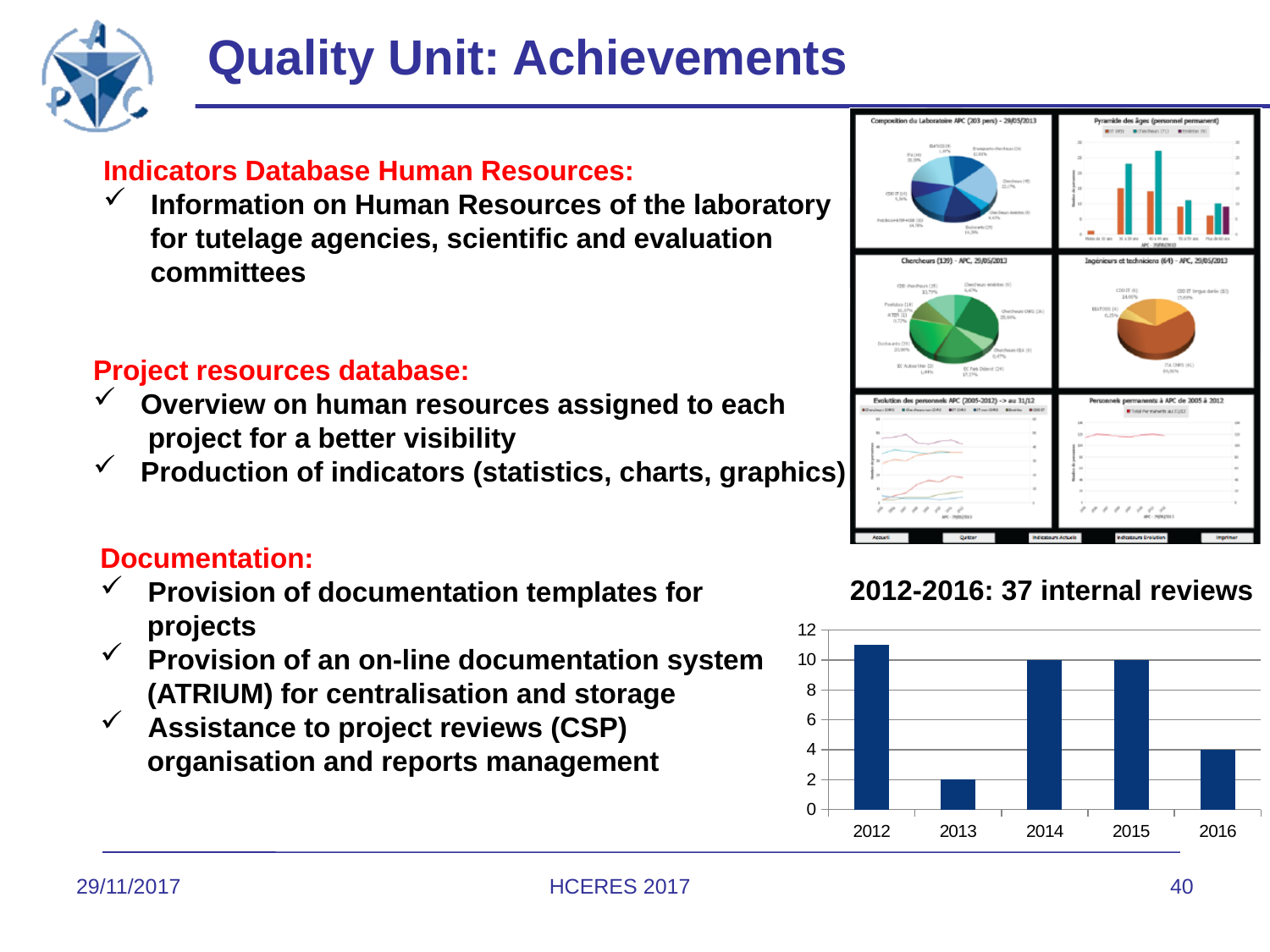
What kind of chart is shown under the heading '2012-2016: 37 internal reviews'? bar chart In the '2012-2016: 37 internal reviews' chart, which year has the larger value, 2014 or 2016? 2014 In the '2012-2016: 37 internal reviews' chart, what is the value for 2014? 10 What is the title printed above the bar chart at the bottom right of the slide? 2012-2016: 37 internal reviews In the '2012-2016: 37 internal reviews' chart, how many years are shown on the x axis? 5 In the '2012-2016: 37 internal reviews' chart, is the value for 2012 greater or less than 10? greater In the '2012-2016: 37 internal reviews' chart, what is the value for 2013? 2 In the '2012-2016: 37 internal reviews' chart, which year has the lowest bar? 2013 In the '2012-2016: 37 internal reviews' chart, what is the value for 2016? 4 In the '2012-2016: 37 internal reviews' chart, which year has the larger value, 2015 or 2013? 2015 In the '2012-2016: 37 internal reviews' chart, what is the difference between the values for 2014 and 2013? 8 In the '2012-2016: 37 internal reviews' chart, which year has the highest bar? 2012